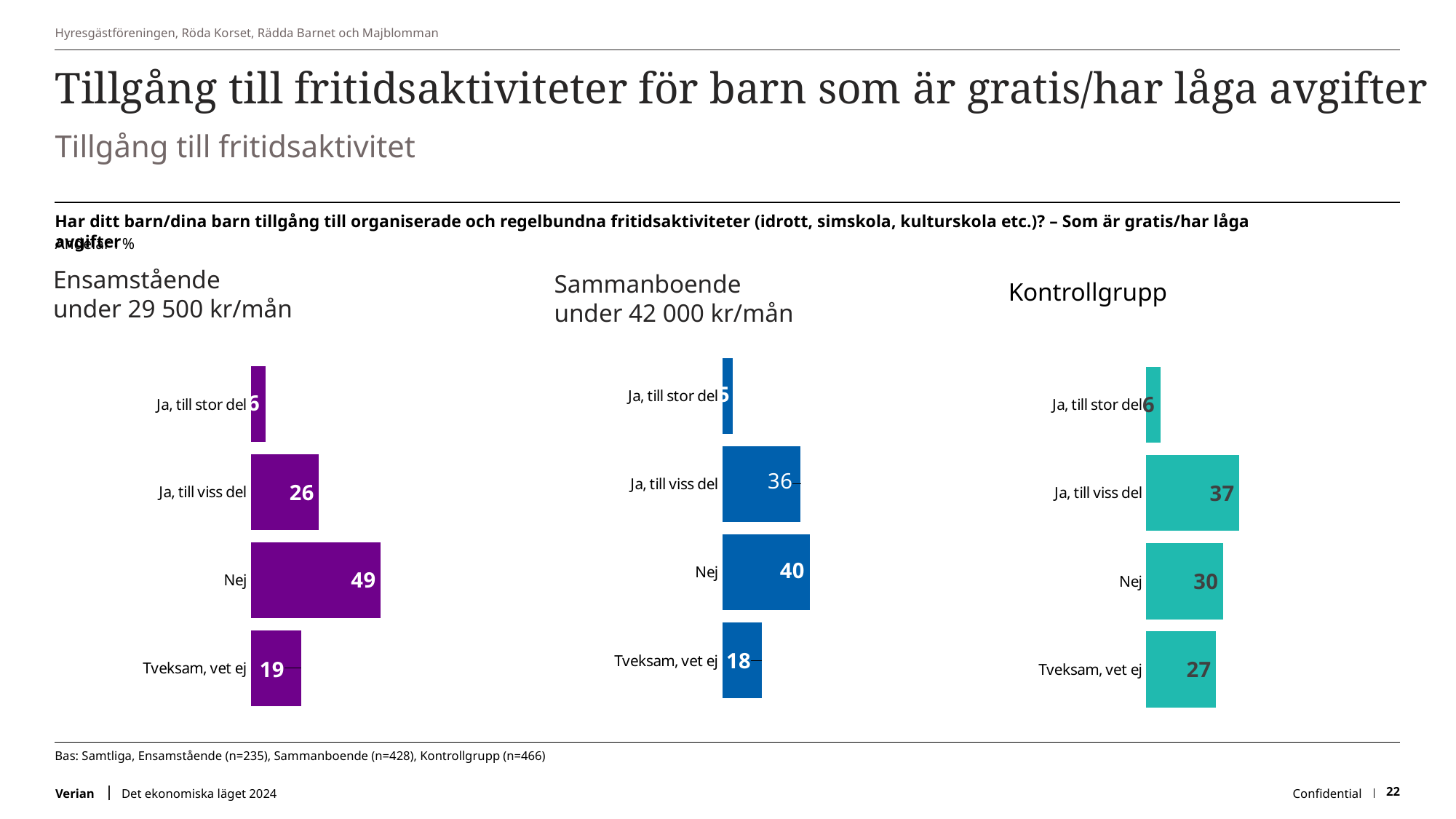
In the 'Sammanboende under 42 000 kr/mån' chart, which is larger: 'Ja, till viss del' or 'Tveksam, vet ej'? Ja, till viss del Which is larger: 'Nej' in the 'Ensamstående under 29 500 kr/mån' chart or 'Nej' in the 'Sammanboende under 42 000 kr/mån' chart? Ensamstående under 29 500 kr/mån In the 'Sammanboende under 42 000 kr/mån' chart, which category has the lowest value? Ja, till stor del What colour are the bars in the 'Sammanboende under 42 000 kr/mån' chart? Blue In the 'Ensamstående under 29 500 kr/mån' chart, what is the value for 'Nej'? 49 How many categories does the 'Kontrollgrupp' chart show? 4 In the 'Sammanboende under 42 000 kr/mån' chart, what is the value for 'Ja, till viss del'? 36 In the 'Kontrollgrupp' chart, what is the difference between 'Nej' and 'Tveksam, vet ej'? 3 In the 'Ensamstående under 29 500 kr/mån' chart, what is the difference between 'Nej' and 'Ja, till viss del'? 23 In the 'Kontrollgrupp' chart, what is the value for 'Tveksam, vet ej'? 27 In the 'Kontrollgrupp' chart, which category has the highest value? Ja, till viss del What kind of chart is the 'Ensamstående under 29 500 kr/mån' chart? Bar chart